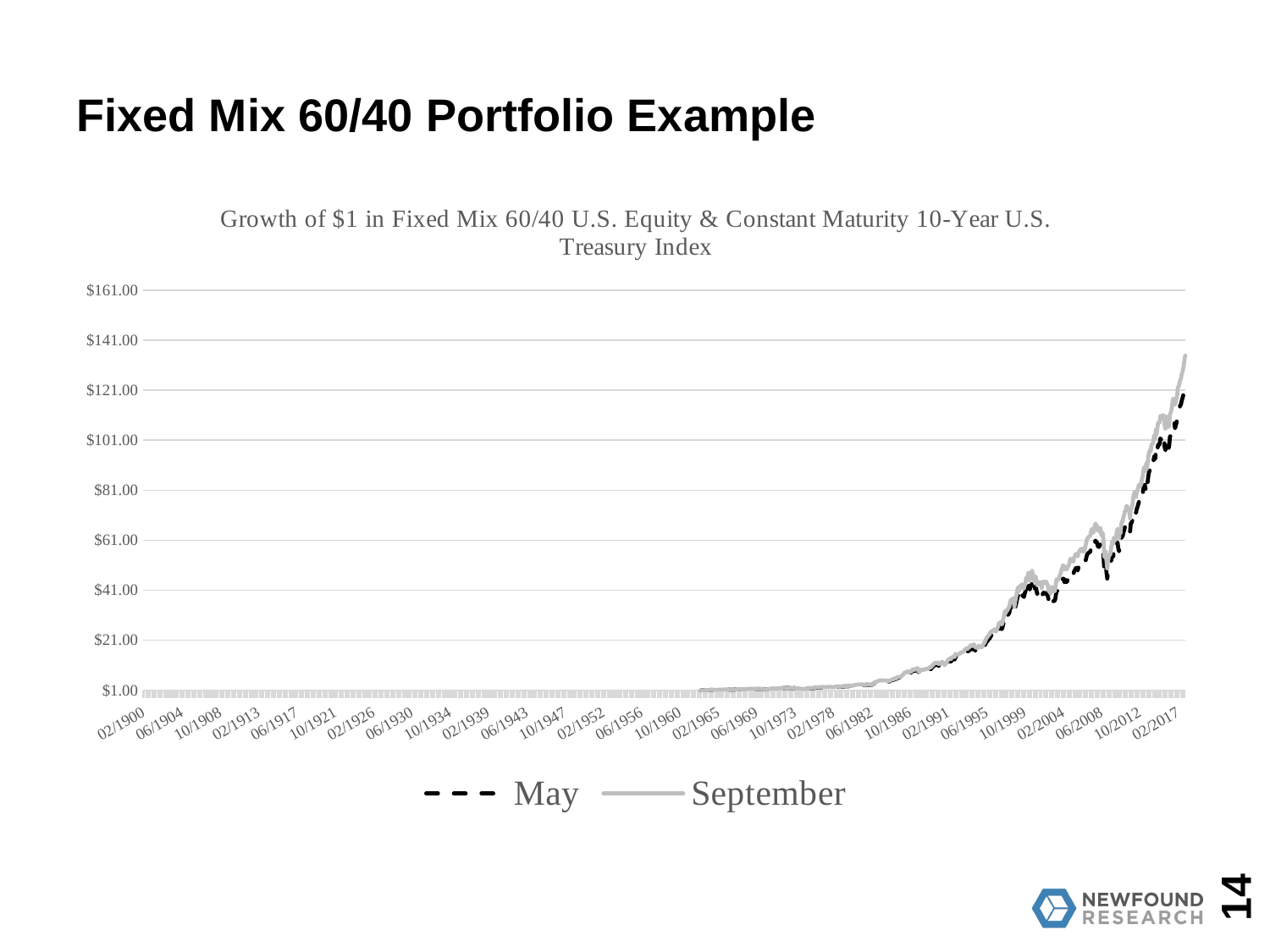
What is the title of the chart? Growth of $1 in Fixed Mix 60/40 U.S. Equity & Constant Maturity 10-Year U.S. Treasury Index How many series does the legend list? 2 At the right end of the chart (around 02/2017), is the September series greater or less than $141.00? less Do the values of the September series generally rise or fall from 02/1900 to 02/2017? Rise Which two series are listed in the legend? May and September At the right end of the chart (around 02/2017), is the May series greater or less than $101.00? greater What kind of chart is shown on the slide? Line chart Around 10/1999, is the September series greater or less than $21.00? greater At the right end of the chart (around 02/2017), which series is higher, May or September? September What is the lowest value shown on the vertical axis? $1.00